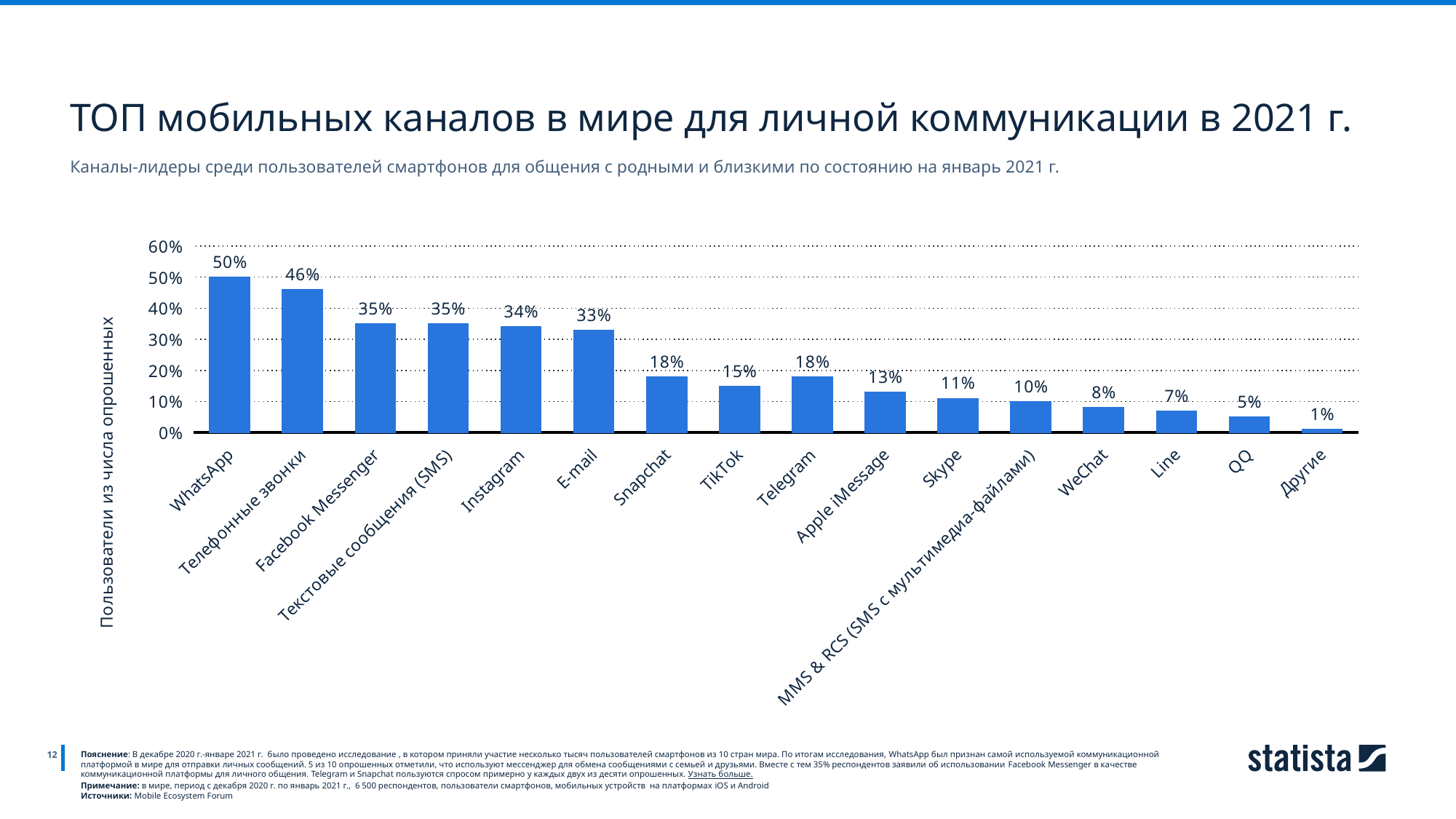
Какая категория имеет наименьшее значение на диаграмме? Другие На сколько процентных пунктов значение для Snapchat больше, чем для TikTok? 3 Какой тип диаграммы показан на слайде? Столбчатая (bar chart) Какое значение показано для WeChat? 8% Что больше: значение для Skype или для Apple iMessage? Apple iMessage На сколько процентных пунктов значение для WhatsApp больше, чем для Телефонных звонков? 4 Какой канал имеет наибольшее значение на диаграмме? WhatsApp Какое значение показано для WhatsApp? 50% Как подписана вертикальная ось диаграммы? Пользователи из числа опрошенных Какое значение показано для Telegram? 18% Сколько категорий (каналов) показано на диаграмме? 16 Что больше: значение для Instagram или для E-mail? Instagram